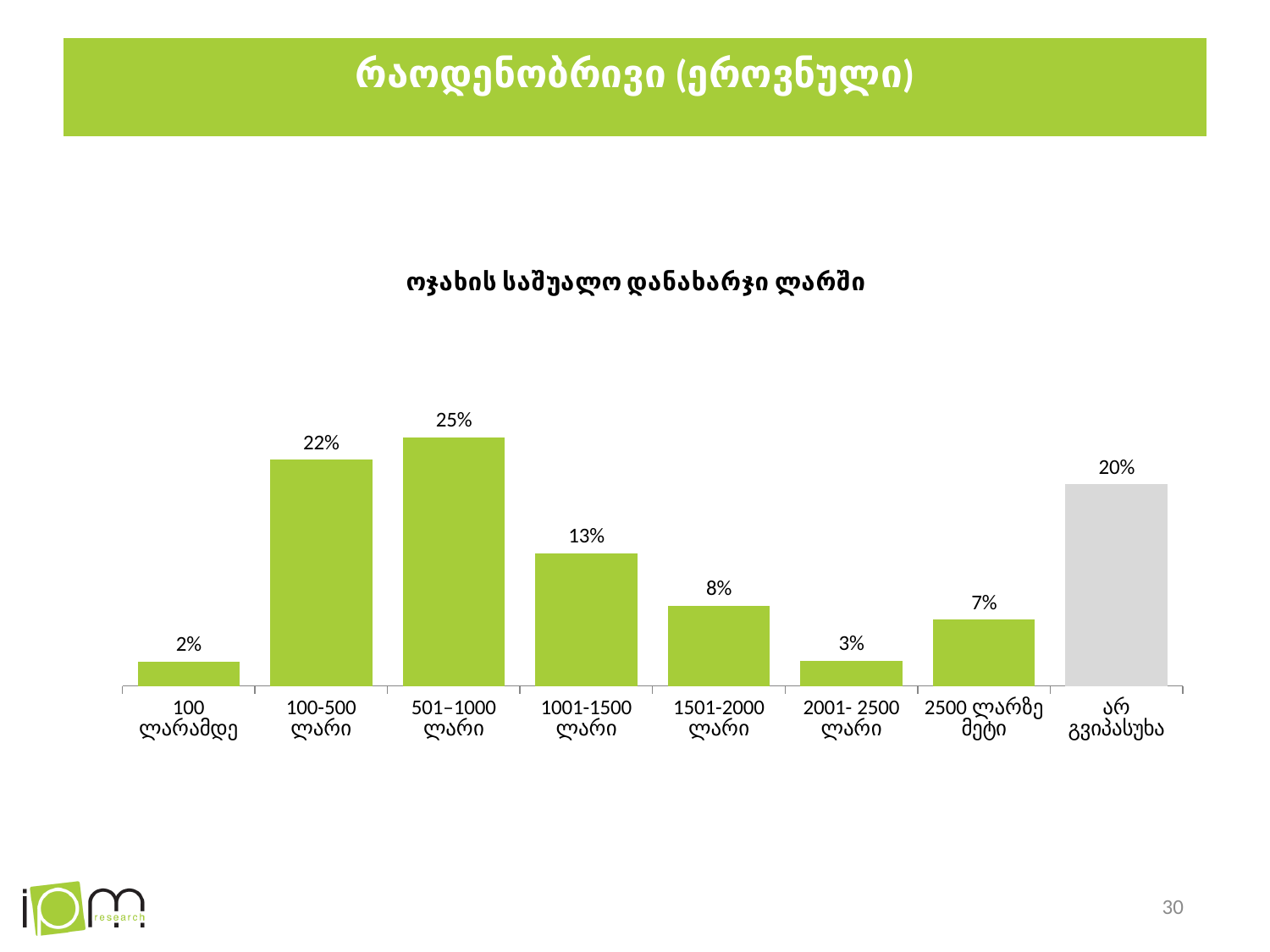
What is the value for the "არ გვიპასუხა" category? 20% What is the difference between the values for "100-500 ლარი" and "1001-1500 ლარი"? 9% What is the value for the "100 ლარამდე" category? 2% What kind of chart is shown on the slide? Bar chart Which is larger, the value for "1501-2000 ლარი" or the value for "2500 ლარზე მეტი"? 1501-2000 ლარი What is the value for the "2500 ლარზე მეტი" category? 7% What is the value for the "501–1000 ლარი" category? 25% What is the title of the chart? ოჯახის საშუალო დანახარჯი ლარში Which category has the highest value? 501–1000 ლარი How many categories are shown on the x axis? 8 Which category's bar is coloured grey instead of green? არ გვიპასუხა Which category has the lowest value? 100 ლარამდე